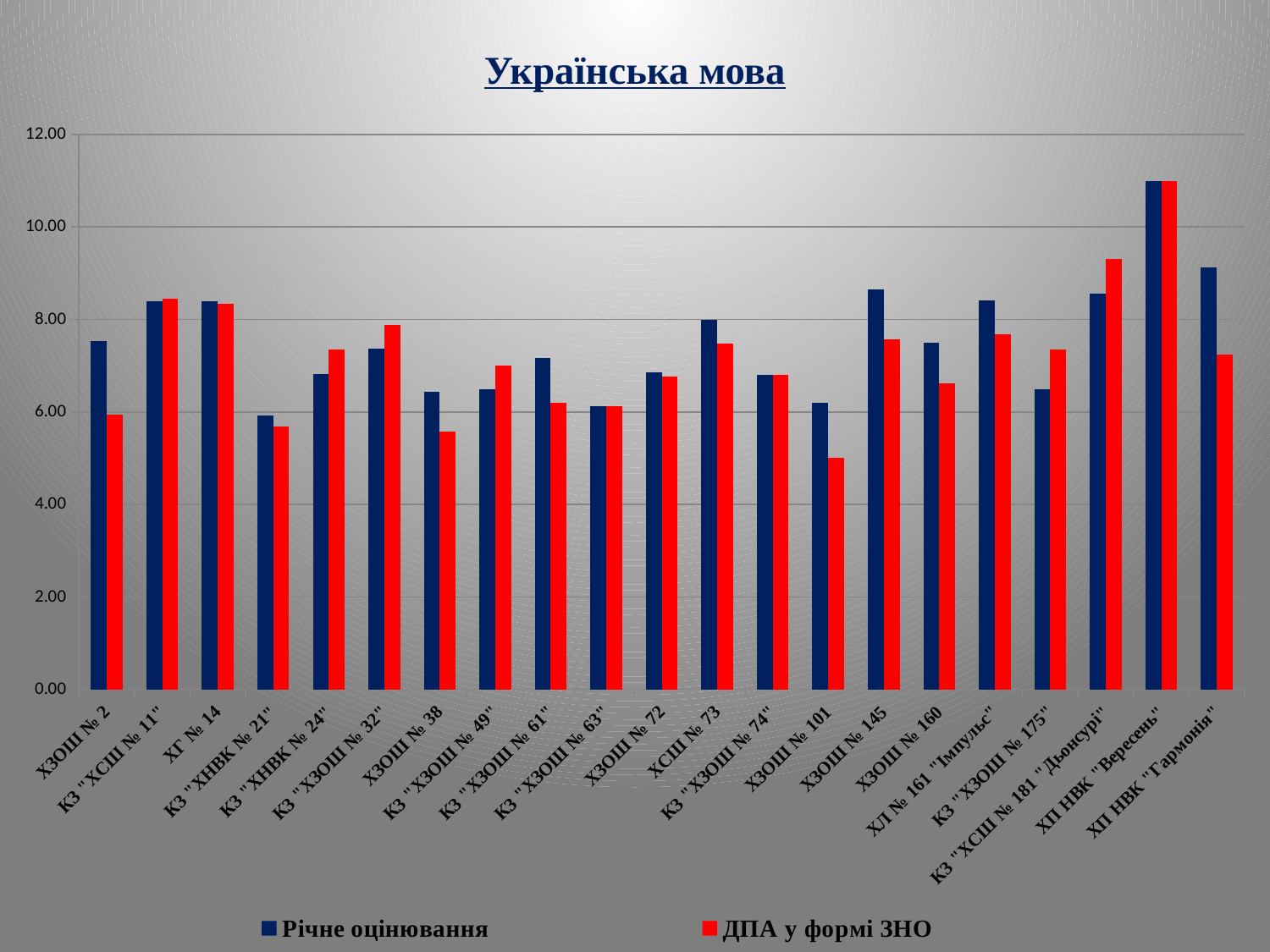
Is the ДПА у формі ЗНО value for ХЗОШ № 101 greater or less than 6.00? less What kind of chart is shown on the slide? bar chart Which school has the highest value for ДПА у формі ЗНО? ХП НВК "Вересень" For ХЗОШ № 2, which is larger: Річне оцінювання or ДПА у формі ЗНО? Річне оцінювання Is the Річне оцінювання value for ХП НВК "Вересень" greater or less than 10.00? greater Is the Річне оцінювання value for ХЗОШ № 145 greater or less than 8.00? greater How many schools (categories) are shown on the x axis? 21 What is the title of the chart? Українська мова Which school has the highest value for Річне оцінювання? ХП НВК "Вересень" For КЗ "ХСШ № 181 "Дьонсурі", which is larger: Річне оцінювання or ДПА у формі ЗНО? ДПА у формі ЗНО Which school has the lowest value for ДПА у формі ЗНО? ХЗОШ № 101 How many series does the legend list? 2